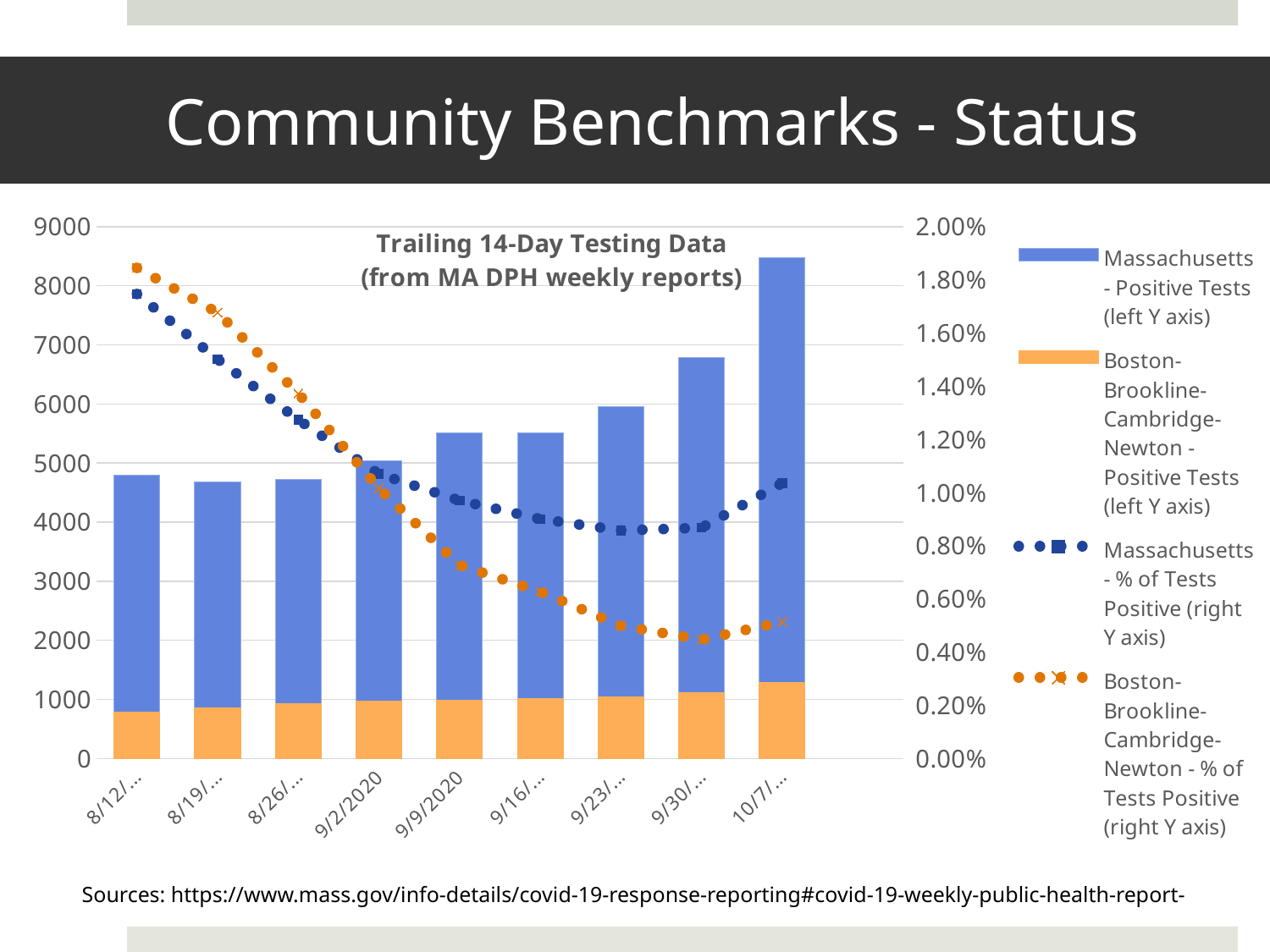
How many dates are shown along the x axis of the chart? 9 What is the title of the chart? Trailing 14-Day Testing Data (from MA DPH weekly reports) What kind of chart is used to plot the Positive Tests series? bar chart Is the top of the stacked bar for 10/7 greater or less than 8000 on the left Y axis? greater Is the Boston-Brookline-Cambridge-Newton - Positive Tests bar for 8/12 greater or less than 1000? less Which Y axis is used for the Boston-Brookline-Cambridge-Newton - % of Tests Positive series? right Y axis On which date is the Massachusetts - Positive Tests bar the tallest? 10/7 How many series does the chart legend list? 4 Which date has the taller stacked bar, 9/16 or 9/23? 9/23 Does the Massachusetts - % of Tests Positive line rise or fall from 8/12 to 9/2/2020? fall Do the stacked bars rise or fall from 9/2/2020 to 10/7? rise Is the top of the stacked bar for 8/12 greater or less than 5000 on the left Y axis? less